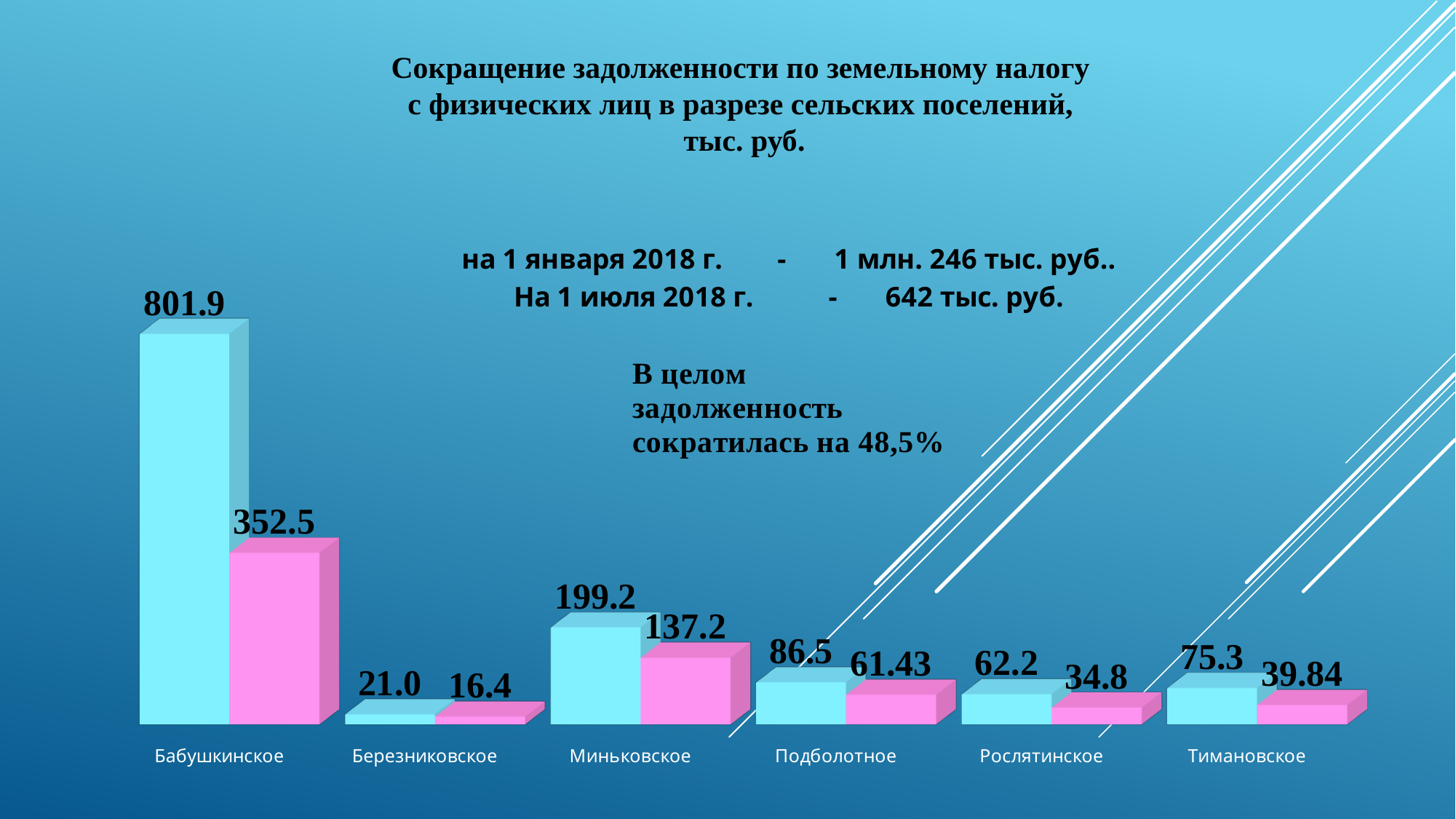
Which is larger: the light blue bar for Подболотное or the light blue bar for Тимановское? Подболотное Which settlement has the lowest pink bar? Березниковское What is the value of the pink bar for Миньковское? 137.2 What unit is stated in the chart title? тыс. руб. What is the value of the light blue bar for Бабушкинское? 801.9 What is the difference between the light blue and pink bars for Рослятинское? 27.4 Which settlement has the highest light blue bar? Бабушкинское What is the value of the light blue bar for Тимановское? 75.3 How many settlements are shown on the x axis? 6 What kind of chart is shown on the slide? Bar chart What is the value of the pink bar for Подболотное? 61.43 What is the difference between the light blue and pink bars for Бабушкинское? 449.4